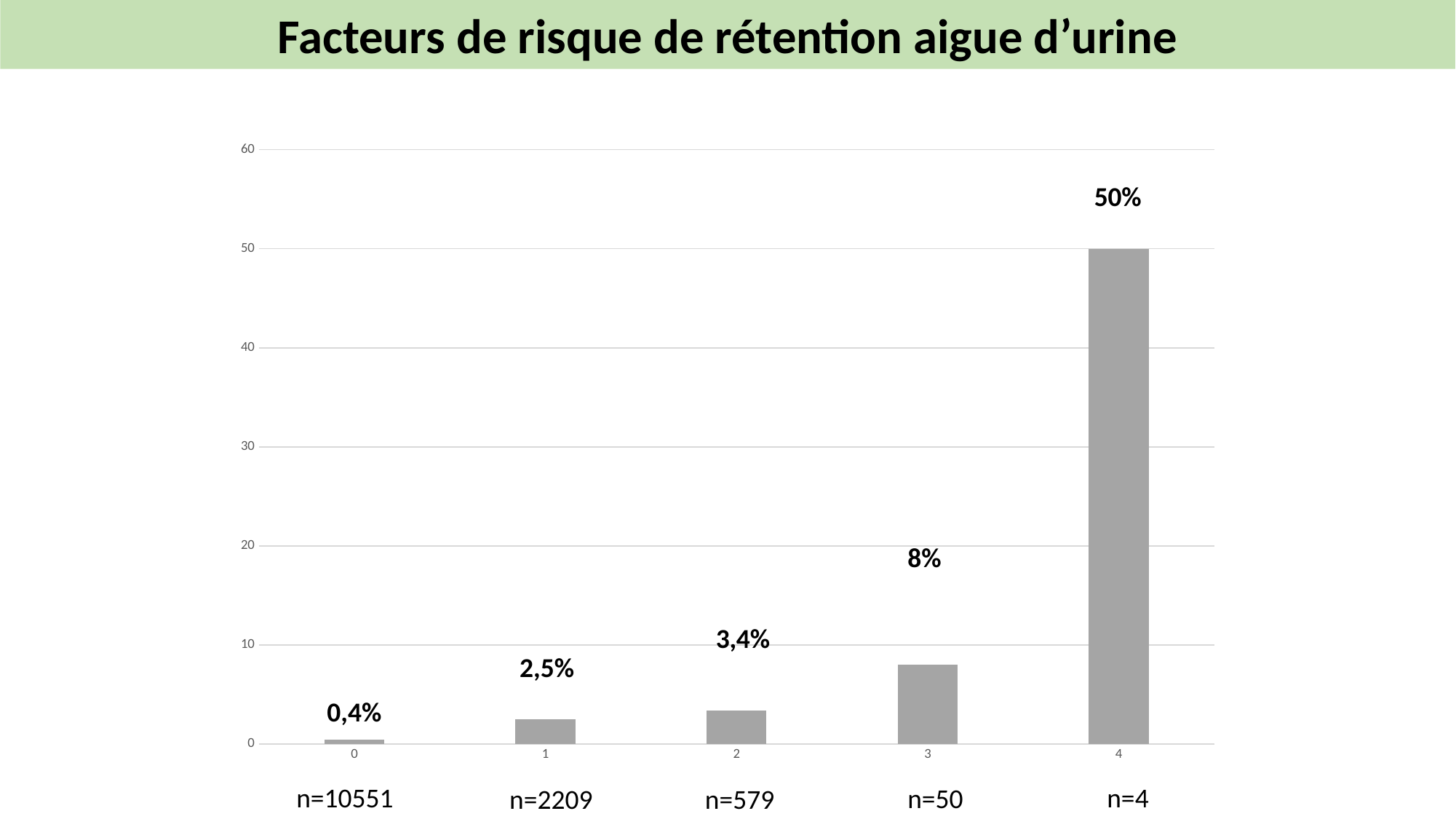
Which category has the lowest value? 0 How many categories are shown on the x axis? 5 What is the value shown for category 2? 3,4% Is the value for category 3 greater or less than 10? less Which category has the highest value? 4 Which has a larger value, category 1 or category 2? 2 What is the difference between the values for category 4 and category 3? 42% Do the values rise or fall from category 0 to category 4? rise What kind of chart is shown on the slide? bar chart What is the value shown for category 0? 0,4% What is the sample size (n) shown under category 1? n=2209 What is the value shown for category 4? 50%